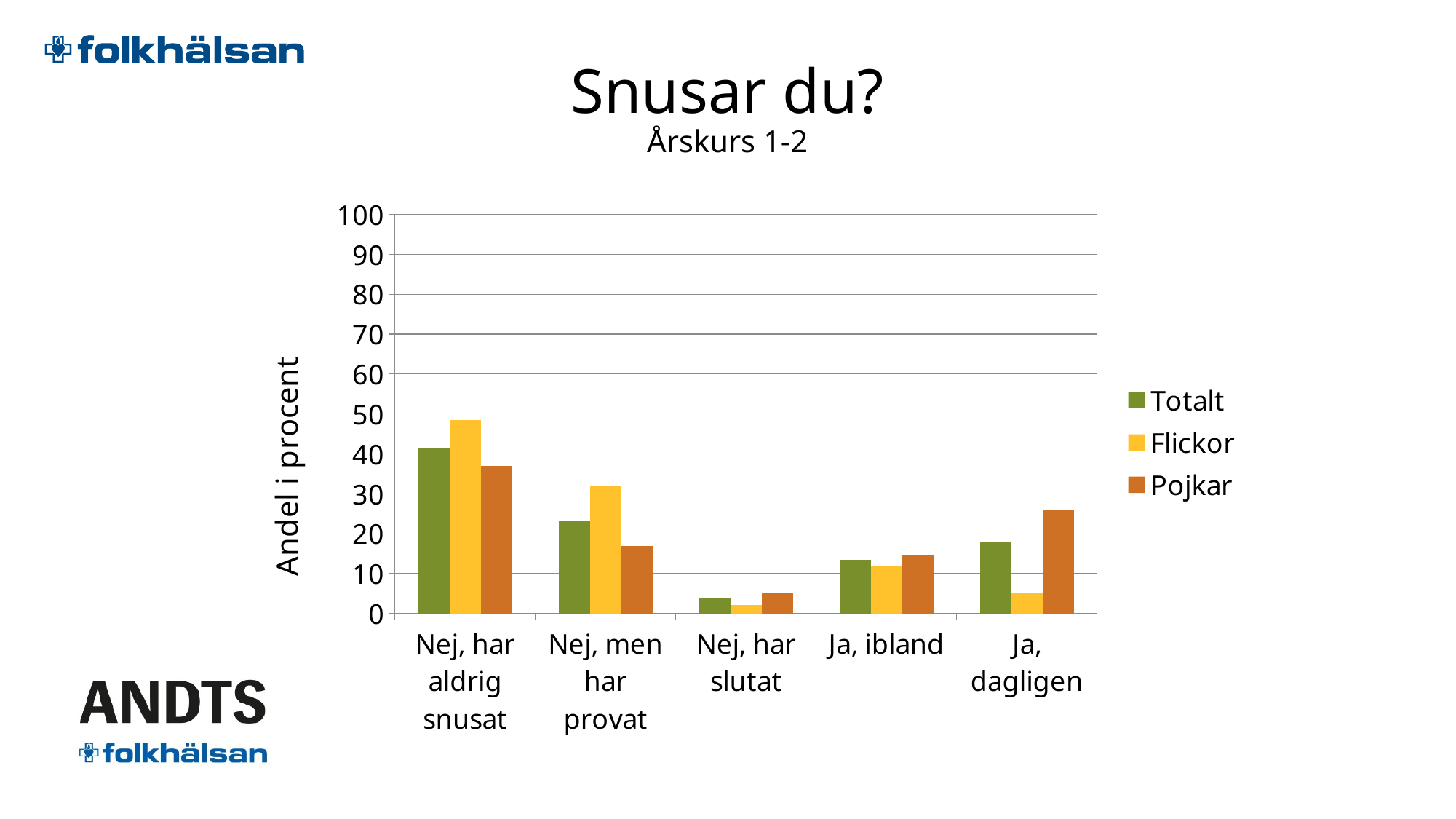
What is the label of the y axis? Andel i procent How many answer categories are shown on the x axis? 5 What kind of chart is shown on the slide? bar chart In the 'Ja, dagligen' category, which is larger: Flickor or Pojkar? Pojkar For the Flickor series, which category has the lowest bar? Nej, har slutat Is the Totalt value for 'Nej, men har provat' greater or less than 30? less Is the Flickor value for 'Nej, har aldrig snusat' greater or less than 40? greater In the 'Nej, men har provat' category, which is larger: Flickor or Pojkar? Flickor How many series does the legend list? 3 Which school years does the chart subtitle say the data covers? Årskurs 1-2 Is the Pojkar value for 'Ja, dagligen' greater or less than 20? greater For the Flickor series, which category has the highest bar? Nej, har aldrig snusat